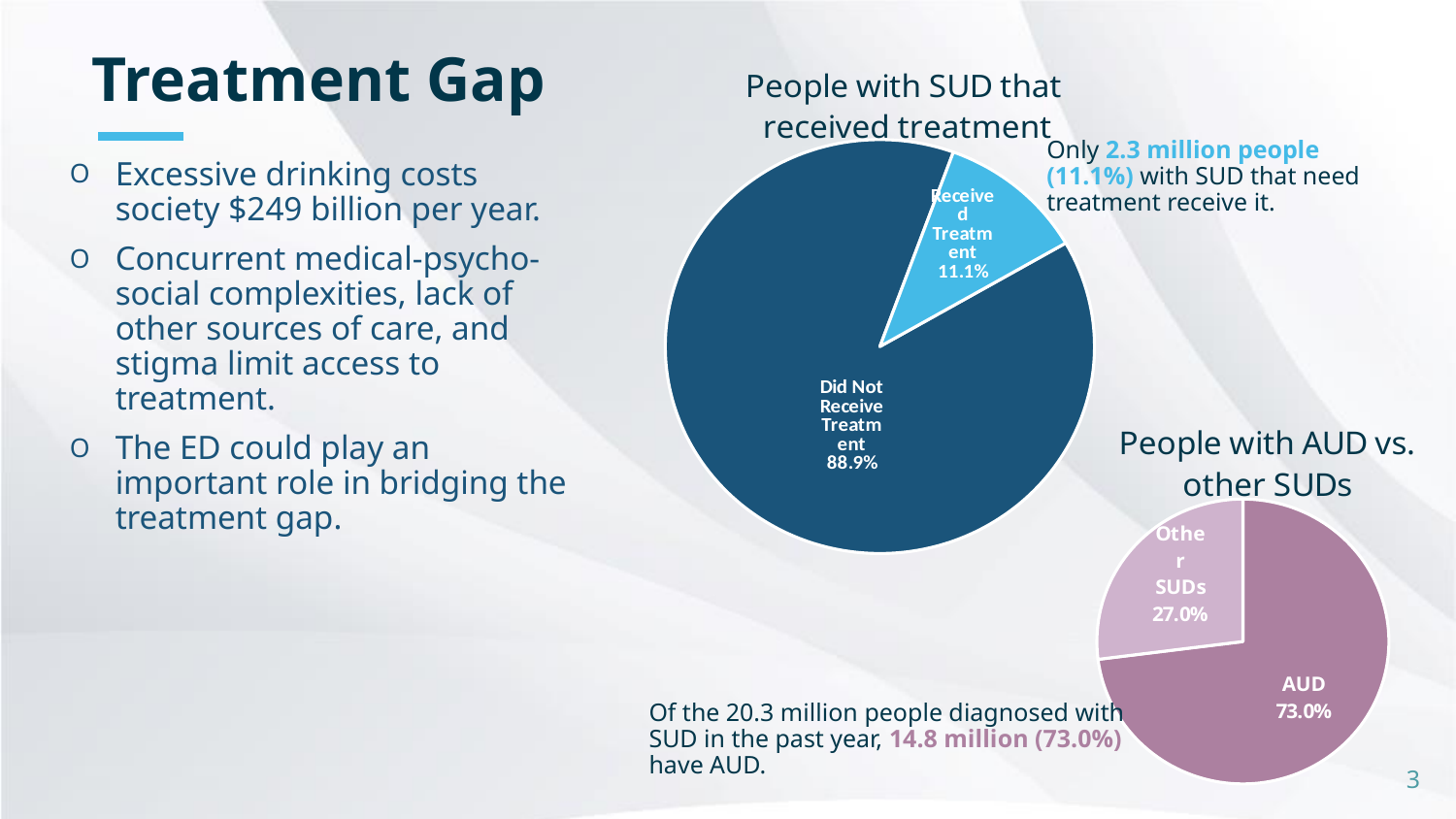
In the 'People with AUD vs. other SUDs' chart, what share is Other SUDs? 27.0% In the 'People with SUD that received treatment' chart, which slice is the largest? Did Not Receive Treatment In the 'People with AUD vs. other SUDs' chart, which slice is the smallest? Other SUDs In the 'People with AUD vs. other SUDs' chart, what is the difference in percentage points between AUD and Other SUDs? 46.0 What is the title of the pie chart in the lower right of the slide? People with AUD vs. other SUDs In the 'People with AUD vs. other SUDs' chart, which is larger, AUD or Other SUDs? AUD In the 'People with AUD vs. other SUDs' chart, what share is AUD? 73.0% In the 'People with SUD that received treatment' chart, what percentage did not receive treatment? 88.9% In the 'People with SUD that received treatment' chart, what percentage received treatment? 11.1% In the 'People with SUD that received treatment' chart, what is the difference in percentage points between those who did not receive treatment and those who did? 77.8 What type of chart is 'People with SUD that received treatment'? Pie chart How many slices does the 'People with AUD vs. other SUDs' chart have? 2